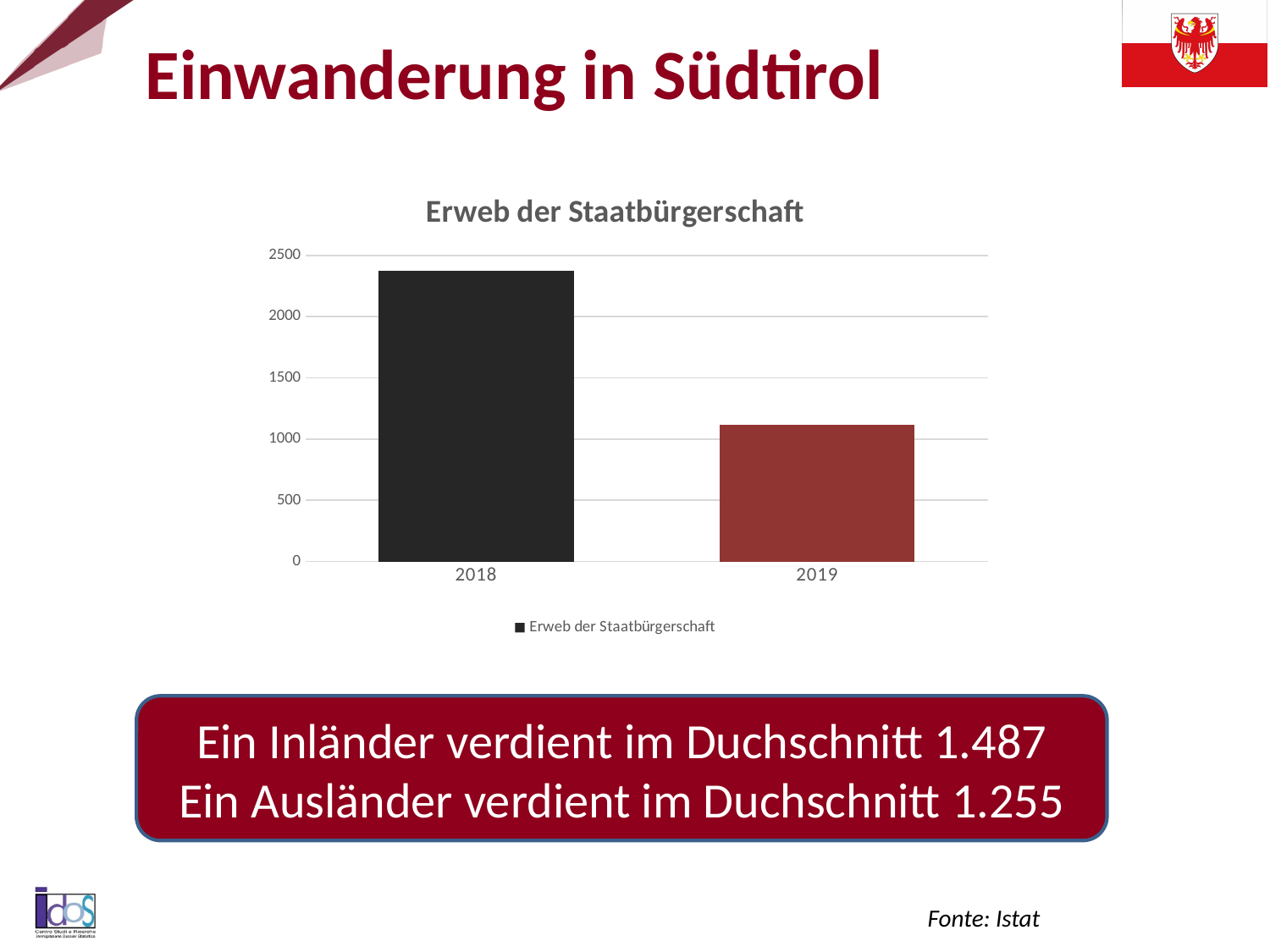
How many categories (years) are shown on the x axis of the chart? 2 What colour is the bar for 2019? dark red Which year has the highest value in the chart? 2018 Which year has the lowest value in the chart? 2019 Is the value for 2019 greater or less than 1500? less Which is larger, the value for 2018 or the value for 2019? 2018 What is the title of the chart? Erweb der Staatbürgerschaft Do the values rise or fall from 2018 to 2019? fall How many series does the chart legend list? 1 Is the value for 2018 greater or less than 2500? less Is the value for 2018 greater or less than 2000? greater What kind of chart is shown on the slide? bar chart